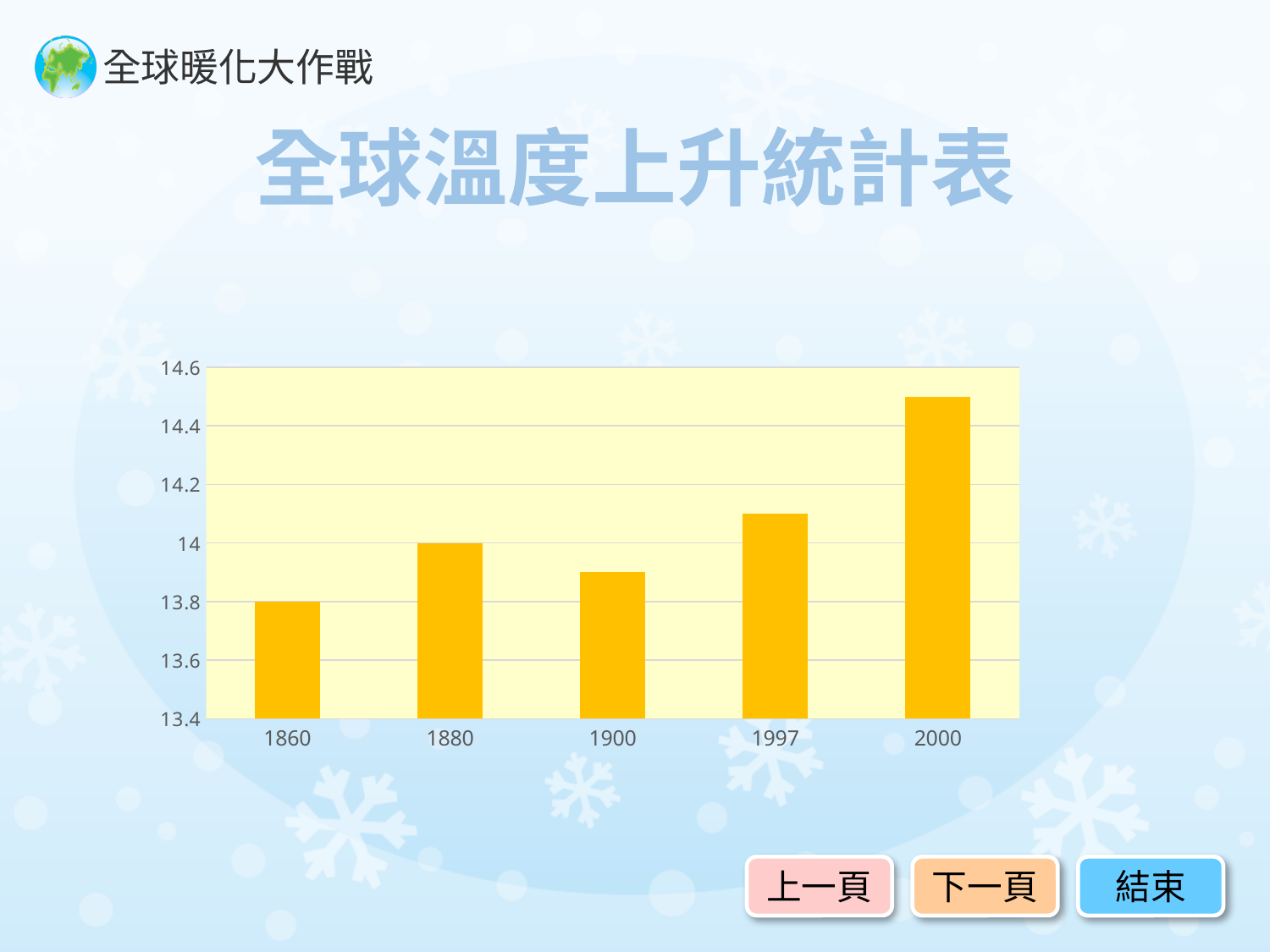
What is the value for 1880? 14 Is the value for 1900 greater or less than 14? less What is the title of the slide above the chart? 全球溫度上升統計表 Which year has the highest value? 2000 Is the value for 2000 greater or less than 14.4? greater Which year has the lowest value? 1860 What kind of chart is shown on the slide? bar chart How many years are shown on the x axis? 5 Is the value for 1997 greater or less than 14.2? less What is the difference between the values for 1880 and 1860? 0.2 What is the value for 1860? 13.8 Which is larger, the value for 1880 or the value for 1900? 1880